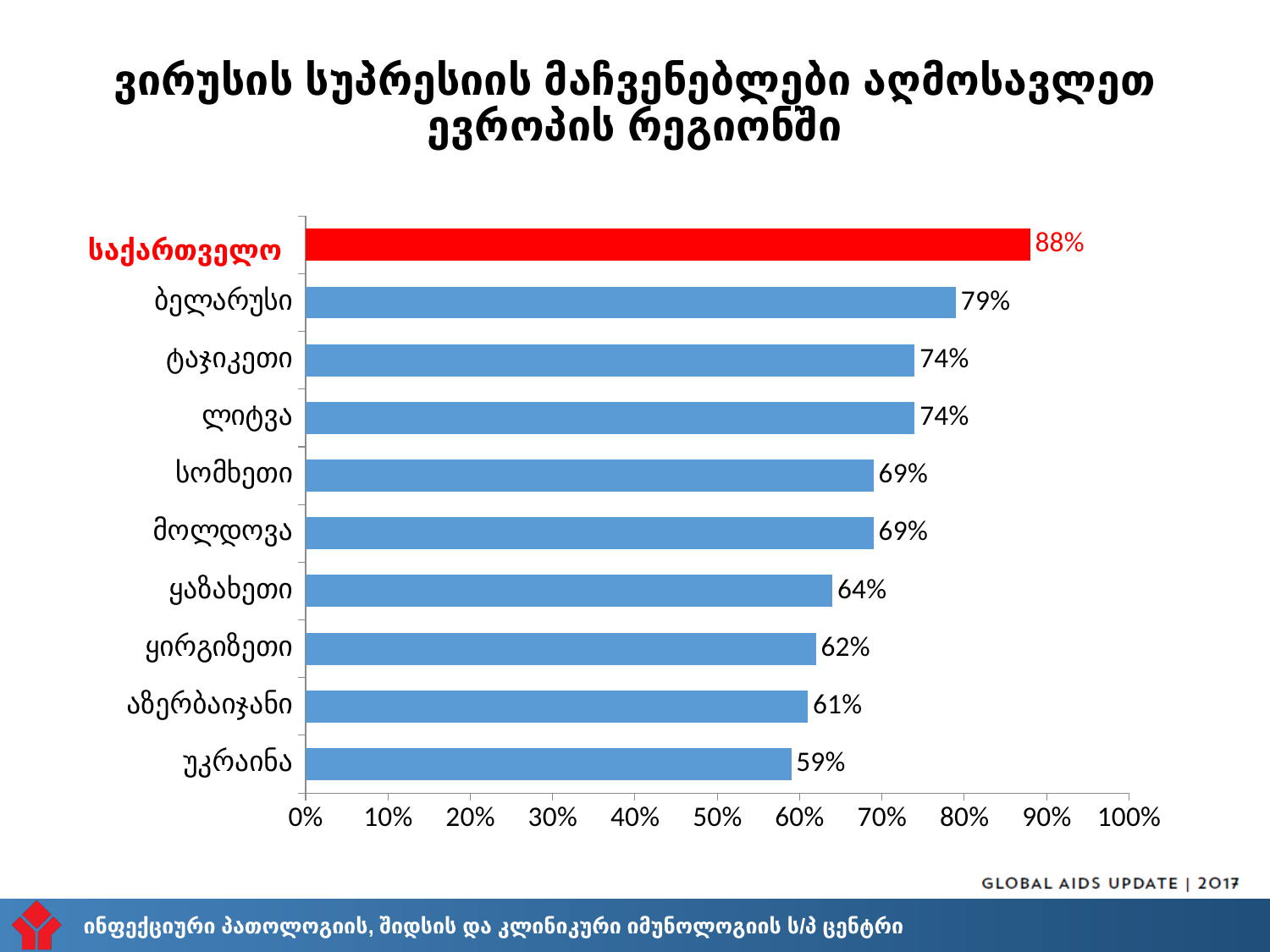
What is the difference between the values for ლიტვა and უკრაინა? 15% How many categories are shown in the chart? 10 Which category has the lowest value? უკრაინა What is the value for ყაზახეთი? 64% What is the value for უკრაინა? 59% What kind of chart is shown on the slide? Bar chart What is the difference between the values for საქართველო and ბელარუსი? 9% What is the value for ბელარუსი? 79% Which category has the highest value? საქართველო Which is larger, the value for ყირგიზეთი or the value for სომხეთი? სომხეთი What is the value for საქართველო? 88% Which bar is coloured red rather than blue? საქართველო